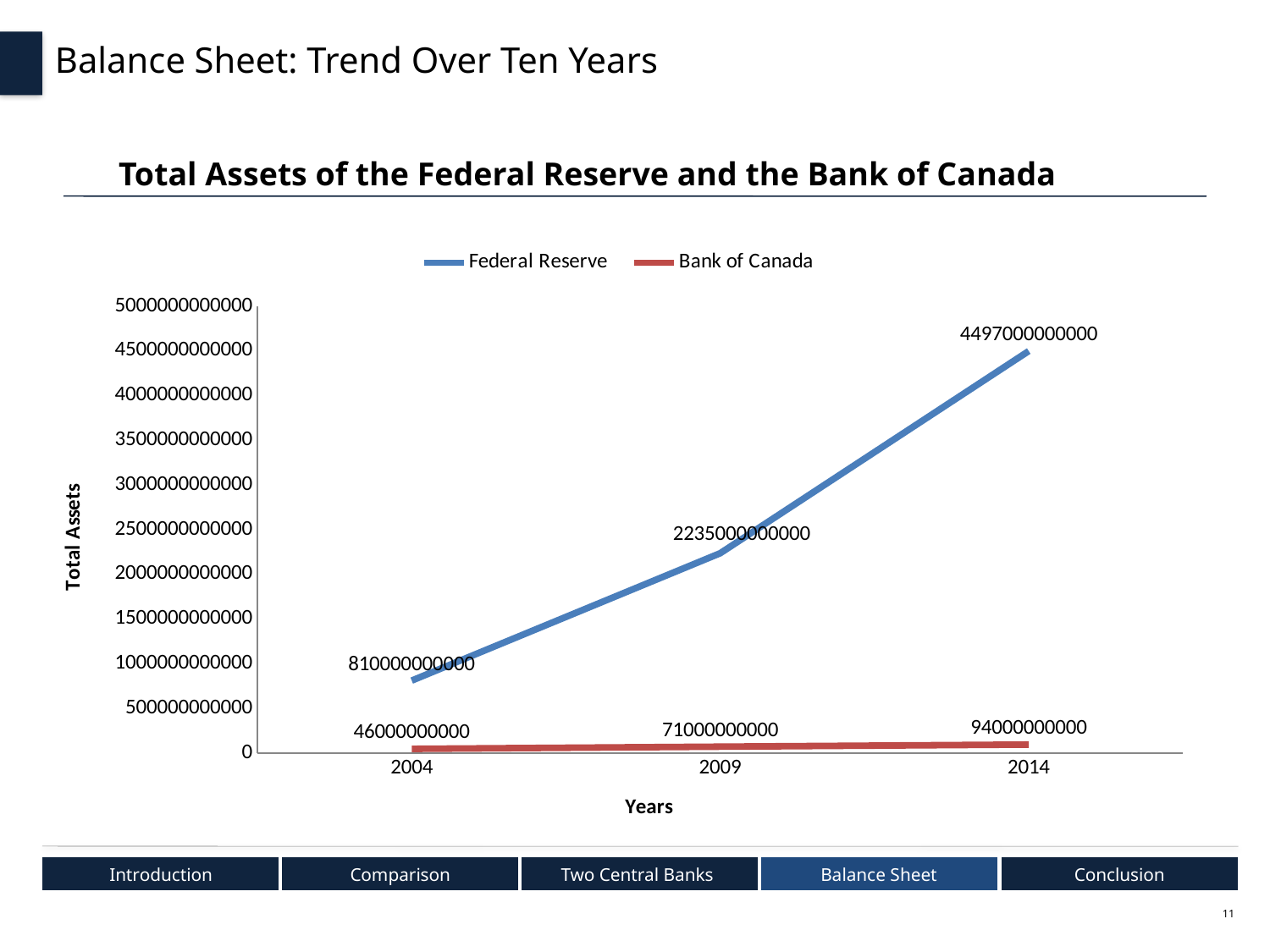
In which year is the Federal Reserve's total assets value highest? 2014 What type of chart is shown on the slide? Line chart What is the difference between the Bank of Canada's total assets in 2014 and in 2004? 48000000000 How many series does the legend list? 2 In which year is the Bank of Canada's total assets value lowest? 2004 What is the Federal Reserve's total assets value in 2014? 4497000000000 What is the Bank of Canada's total assets value in 2009? 71000000000 What is the difference between the Federal Reserve's total assets in 2014 and in 2004? 3687000000000 How many years are plotted on the x axis? 3 Do the Federal Reserve's total assets rise or fall from 2004 to 2014? Rise What is the Federal Reserve's total assets value in 2004? 810000000000 Which series has the larger value in 2009, Federal Reserve or Bank of Canada? Federal Reserve